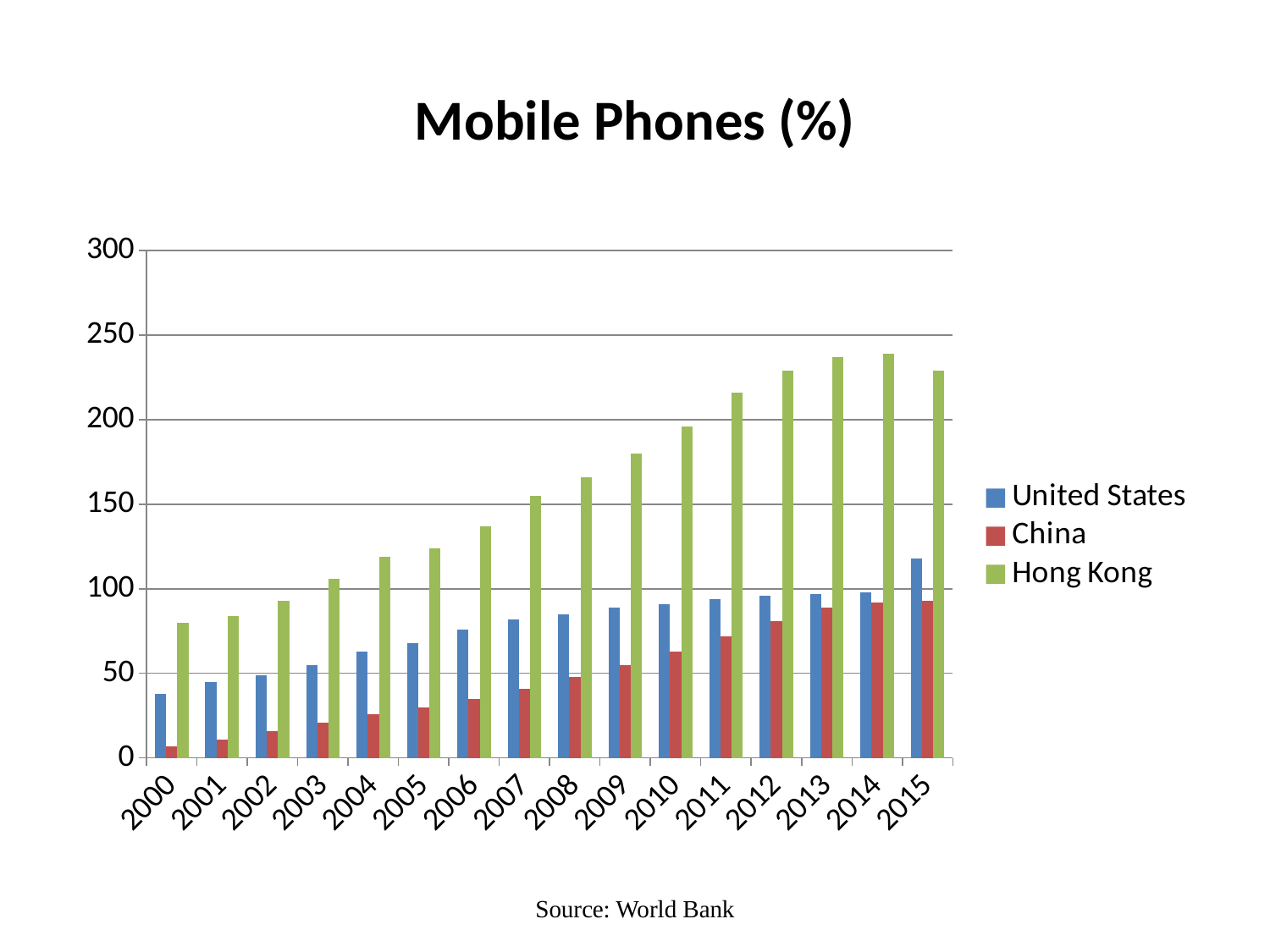
Is the value for Hong Kong in 2014 greater or less than 200? greater In 2010, which is larger: the value for Hong Kong or the value for United States? Hong Kong Is the value for China in 2000 greater or less than 50? less Is the value for United States in 2015 greater or less than 100? greater Which series has the highest value in 2015? Hong Kong What is the title of the chart? Mobile Phones (%) How many series does the legend list? 3 Which series has the lowest value in 2000? China What kind of chart is shown on the slide? bar chart How many years are shown on the x axis? 16 Do the values for China rise or fall from 2000 to 2015? rise